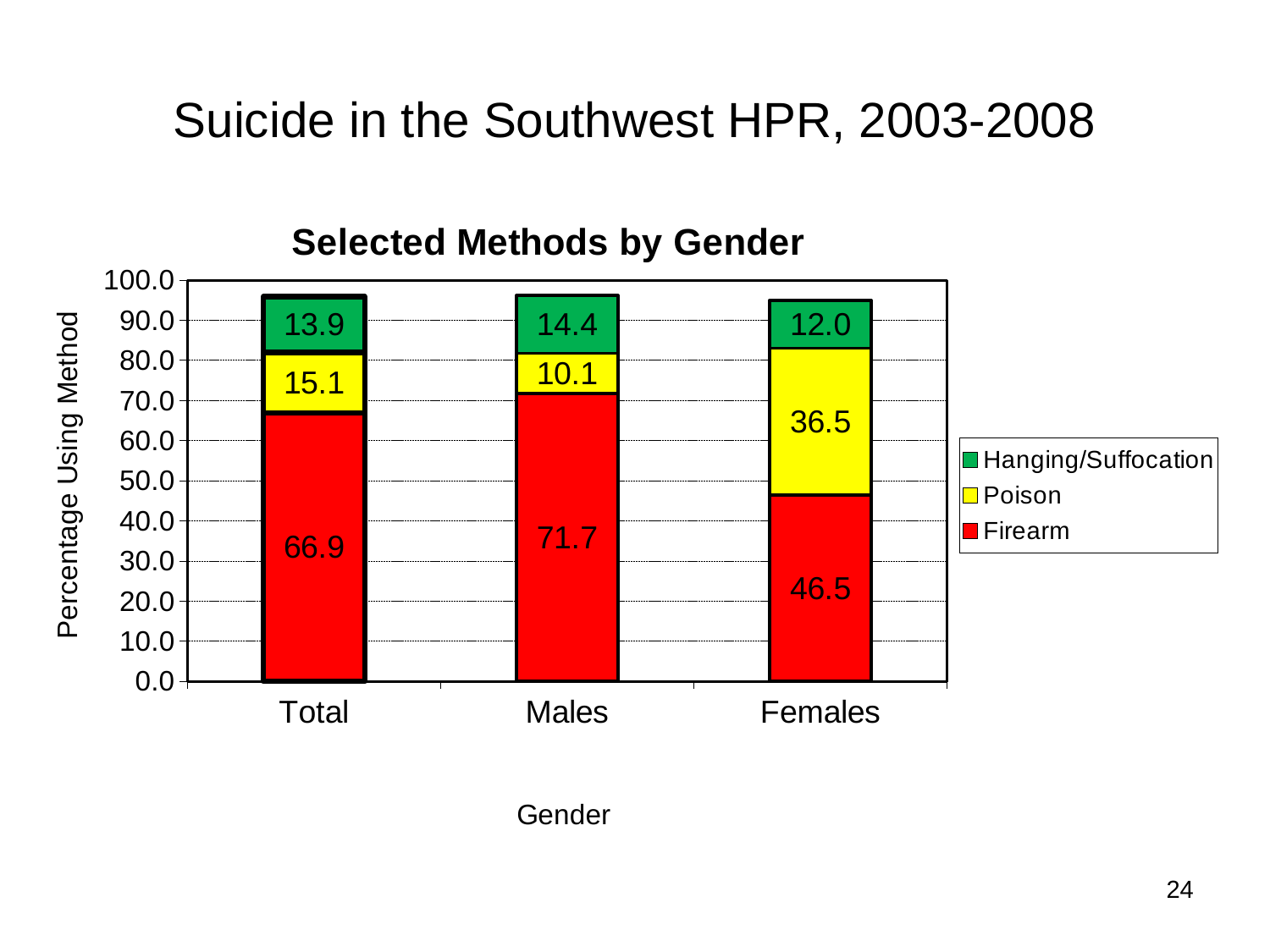
What is the Poison value for Males? 10.1 What is the total of the stacked bar for Females? 95.0 What is the Firearm value for Females? 46.5 Which category has the highest Firearm value? Males What is the difference between the Firearm values for Males and Females? 25.2 How many categories are shown on the x axis? 3 Which category has the lowest Poison value? Males Which is larger, the Poison value for Females or the Poison value for Total? Females How many series does the legend list? 3 What is the title of the chart? Selected Methods by Gender What is the Hanging/Suffocation value for Total? 13.9 What kind of chart is shown? Stacked bar chart